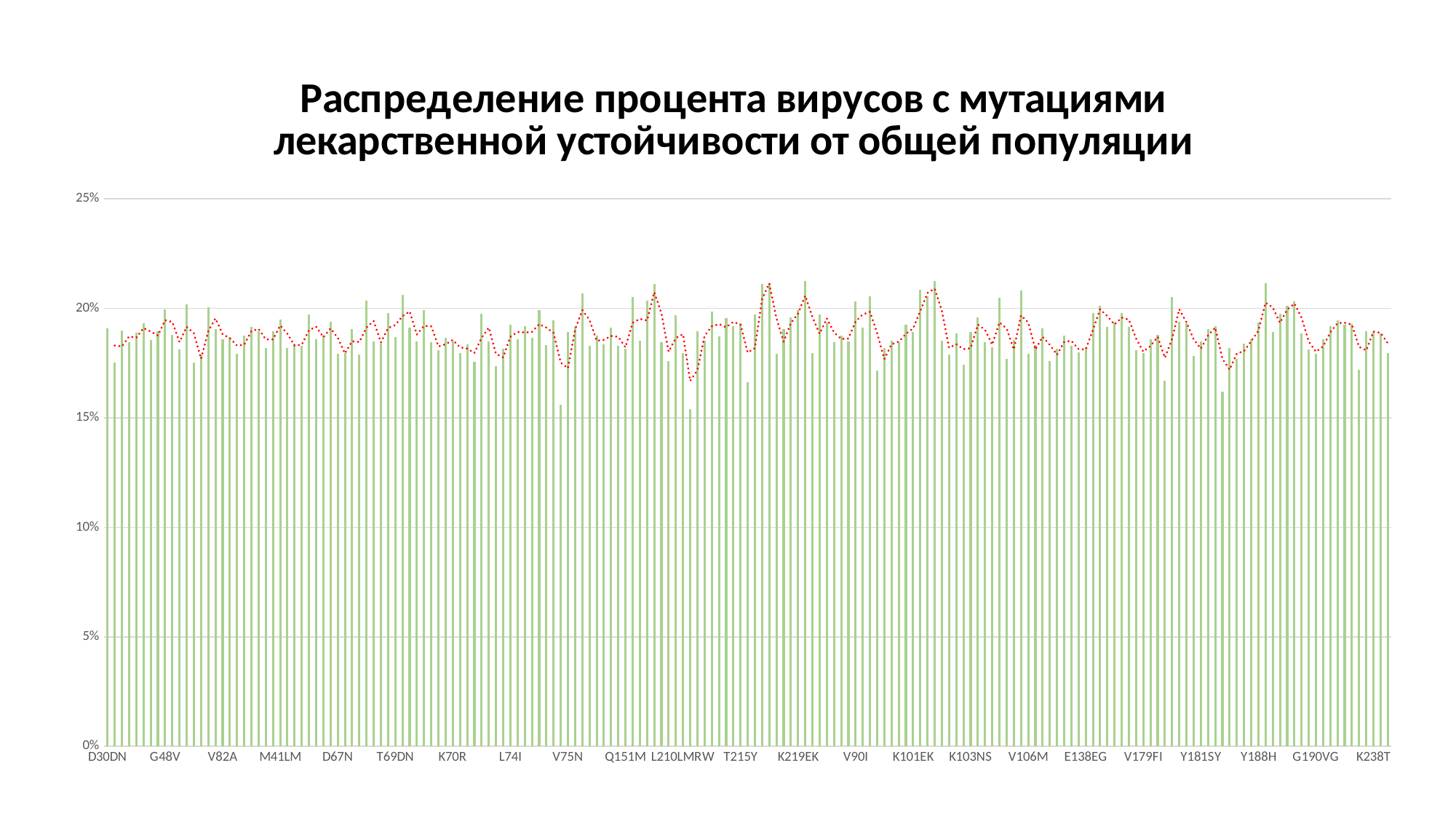
What kind of chart is shown on the slide? bar chart How many category labels are printed along the x axis? 23 Is the value for D30DN greater or less than 15%? greater Is the value for T215Y greater or less than 25%? less What is the highest value shown on the y axis? 25% Is the value for G48V greater or less than 10%? greater Do the bar values show a strong rising or falling trend along the x axis, or stay roughly level? roughly level Which category label appears first on the x axis? D30DN What is the title of the chart? Распределение процента вирусов с мутациями лекарственной устойчивости от общей популяции